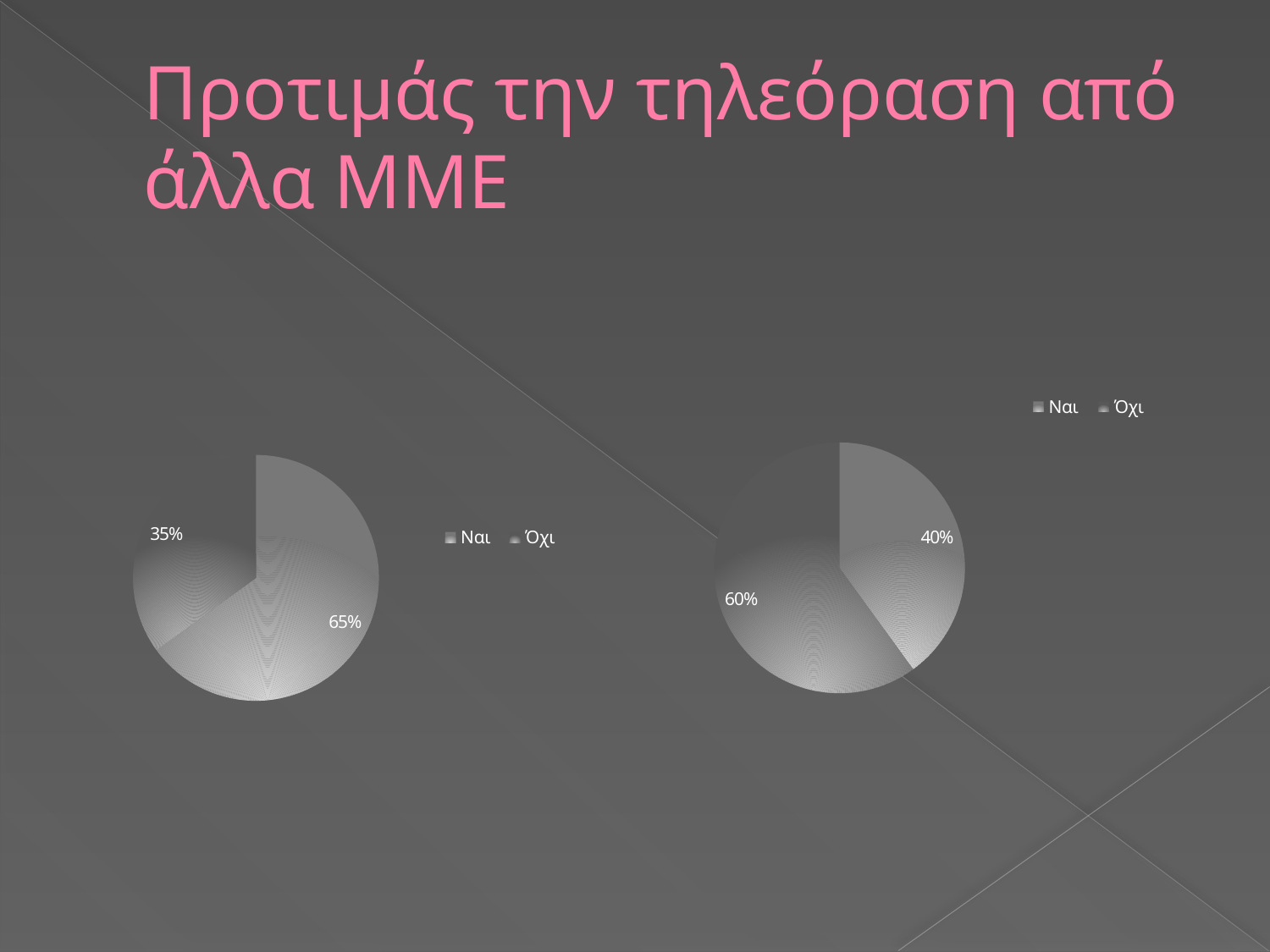
In the right pie chart, what is the difference between the two slices' percentages? 20% How many slices does the left pie chart have? 2 What kind of chart is the right chart on the slide? pie chart In the left pie chart, what percentage is shown for Ναι? 65% In the right pie chart, what percentage is shown for Όχι? 60% In the right pie chart, what percentage is shown for Ναι? 40% How many entries does the legend of the right pie chart list? 2 In the left pie chart, which category has the largest slice? Ναι In the right pie chart, which category has the largest slice? Όχι In the left pie chart, what is the difference between the two slices' percentages? 30% What kind of chart is the left chart on the slide? pie chart In the left pie chart, what percentage is shown for Όχι? 35%